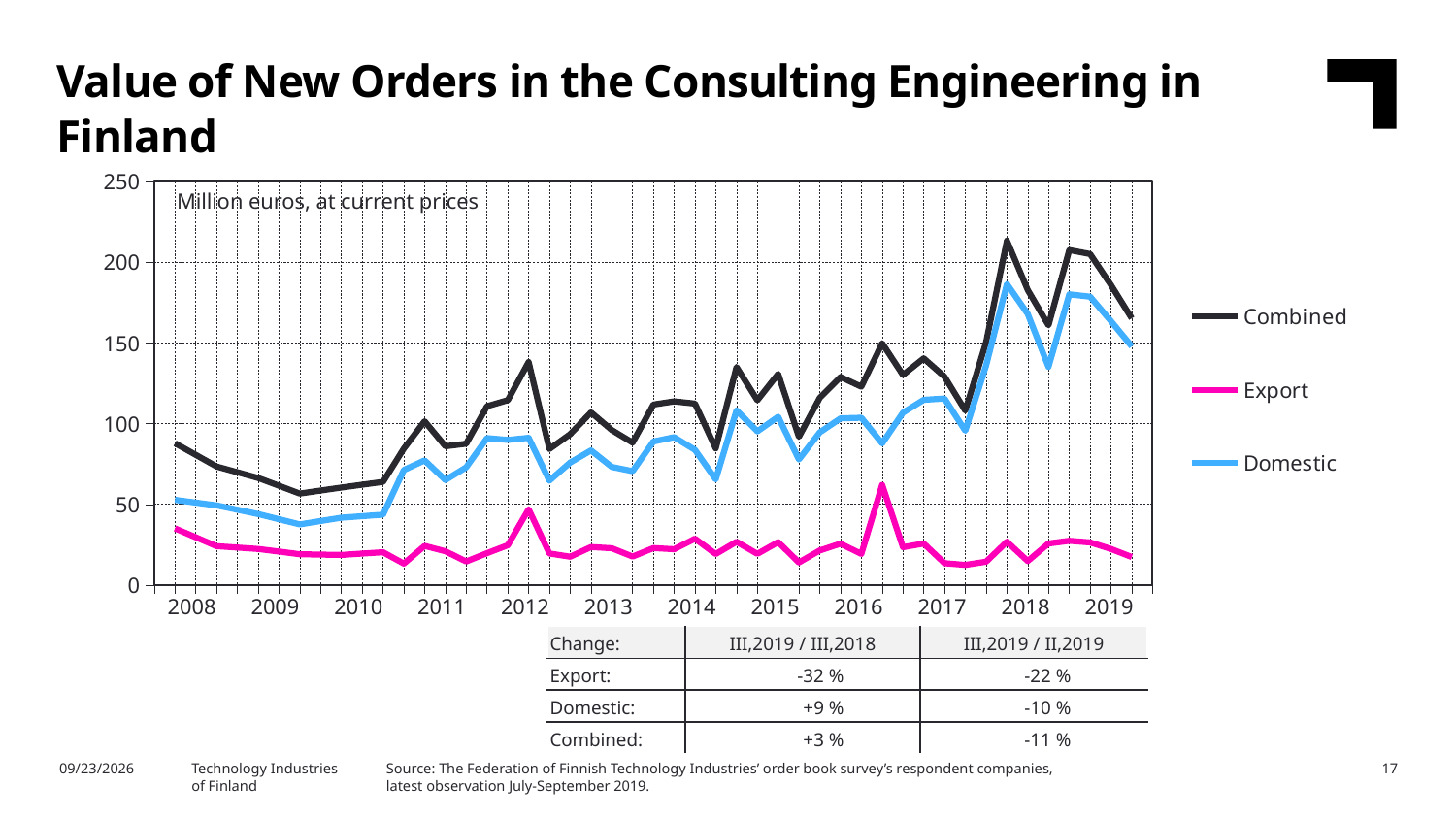
Does the Combined series overall rise or fall from 2008 to 2019? rise How many series does the chart legend list? 3 Which series has the highest values across the whole chart? Combined Is the peak value of the Combined series in late 2017 greater or less than 200? greater Is the Export value at the start of 2008 greater or less than 50? less Which series are listed in the chart legend? Combined, Export, Domestic In 2018, which is larger, the Combined value or the Export value? Combined What unit is stated inside the chart area? Million euros, at current prices How many years are labelled on the x axis? 12 Is the Combined value at the last observation in 2019 greater or less than 150? greater Which series has the lowest values across the whole chart? Export What kind of chart is shown on the slide? line chart